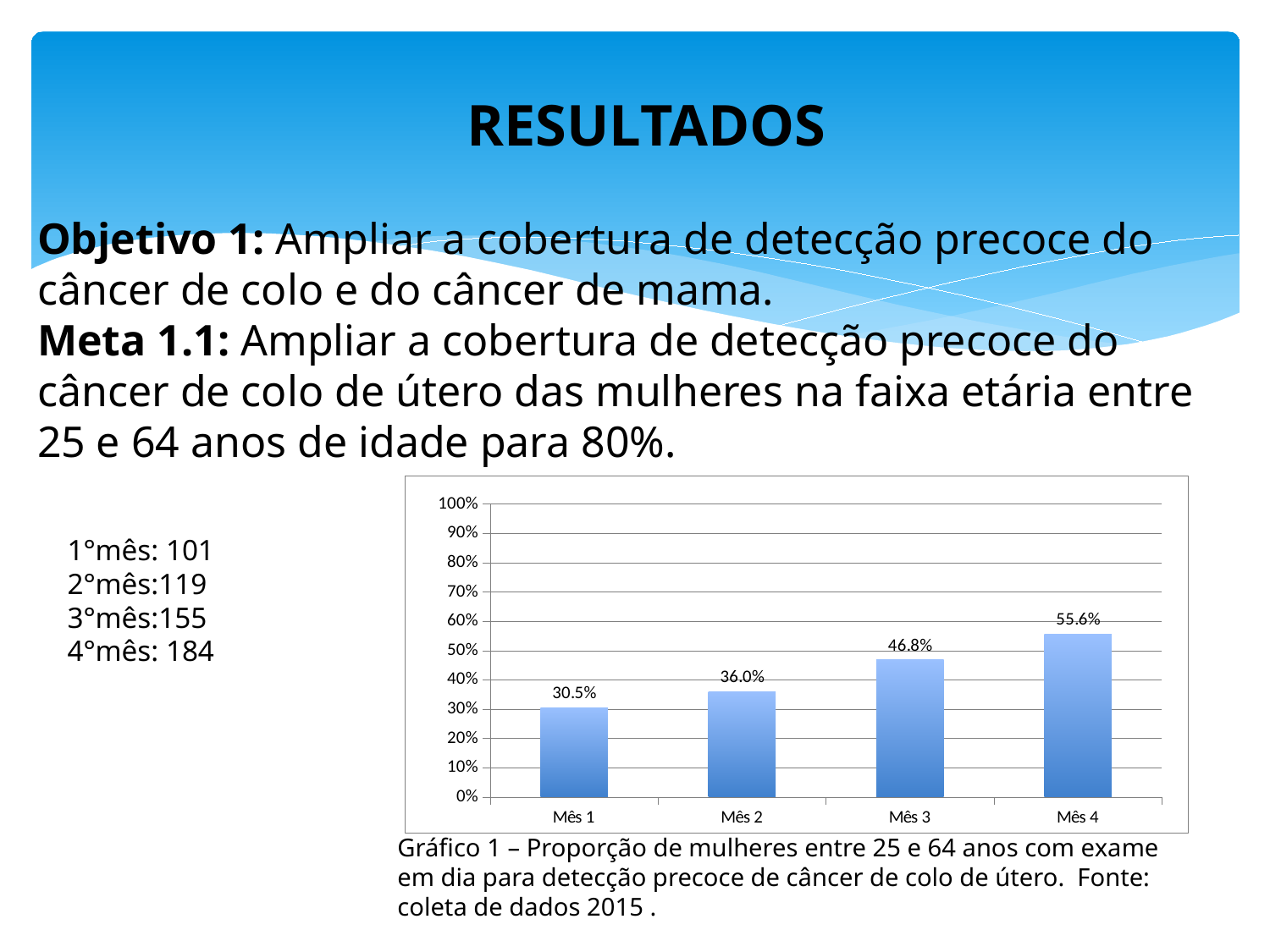
What is the difference between the values for Mês 3 and Mês 2? 10.8% Is the value for Mês 4 greater or less than 50%? greater What is the difference between the values for Mês 4 and Mês 1? 25.1% Which is larger, the value for Mês 2 or the value for Mês 3? Mês 3 How many months are shown on the x axis? 4 Which month has the highest value? Mês 4 What is the value for Mês 3? 46.8% What kind of chart is shown on the slide? bar chart What is the value for Mês 1? 30.5% Which month has the lowest value? Mês 1 Do the values rise or fall from Mês 1 to Mês 4? rise What is the value for Mês 4? 55.6%